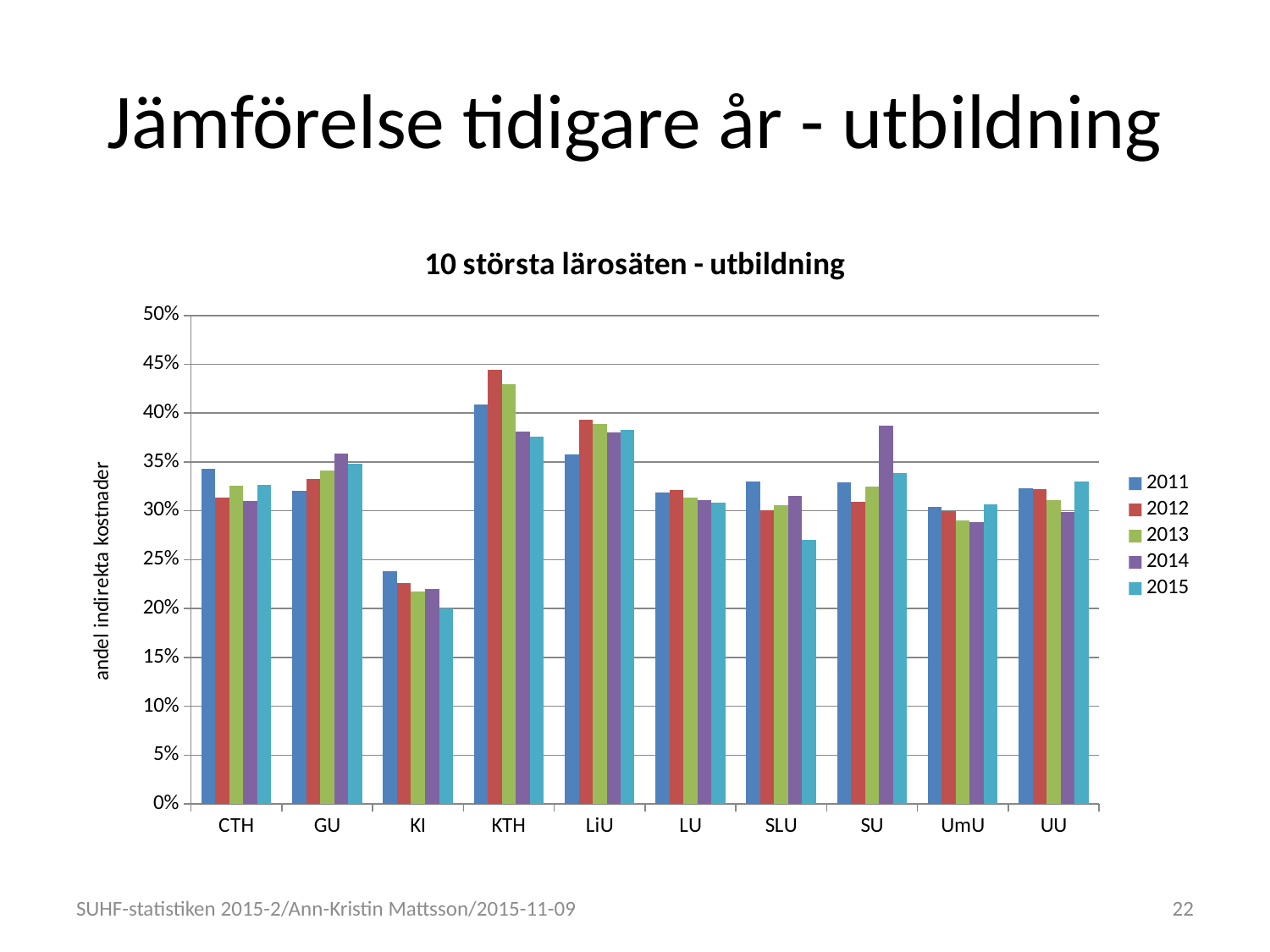
Is the value for KI in 2015 greater or less than 25%? less Is the value for SU in 2014 greater or less than 35%? greater Do the values for KI rise or fall from 2011 to 2015? fall How many series does the legend list? 5 Which is larger, the 2015 value for SLU or the 2015 value for SU? SU Which is larger, the 2011 value for KTH or the 2011 value for LiU? KTH How many institutions are shown on the x axis? 10 Which institution has the lowest value for 2015? KI What kind of chart is shown on the slide? bar chart Is the value for KTH in 2012 greater or less than 40%? greater What is the title of the chart? 10 största lärosäten - utbildning Which institution has the highest value for 2012? KTH